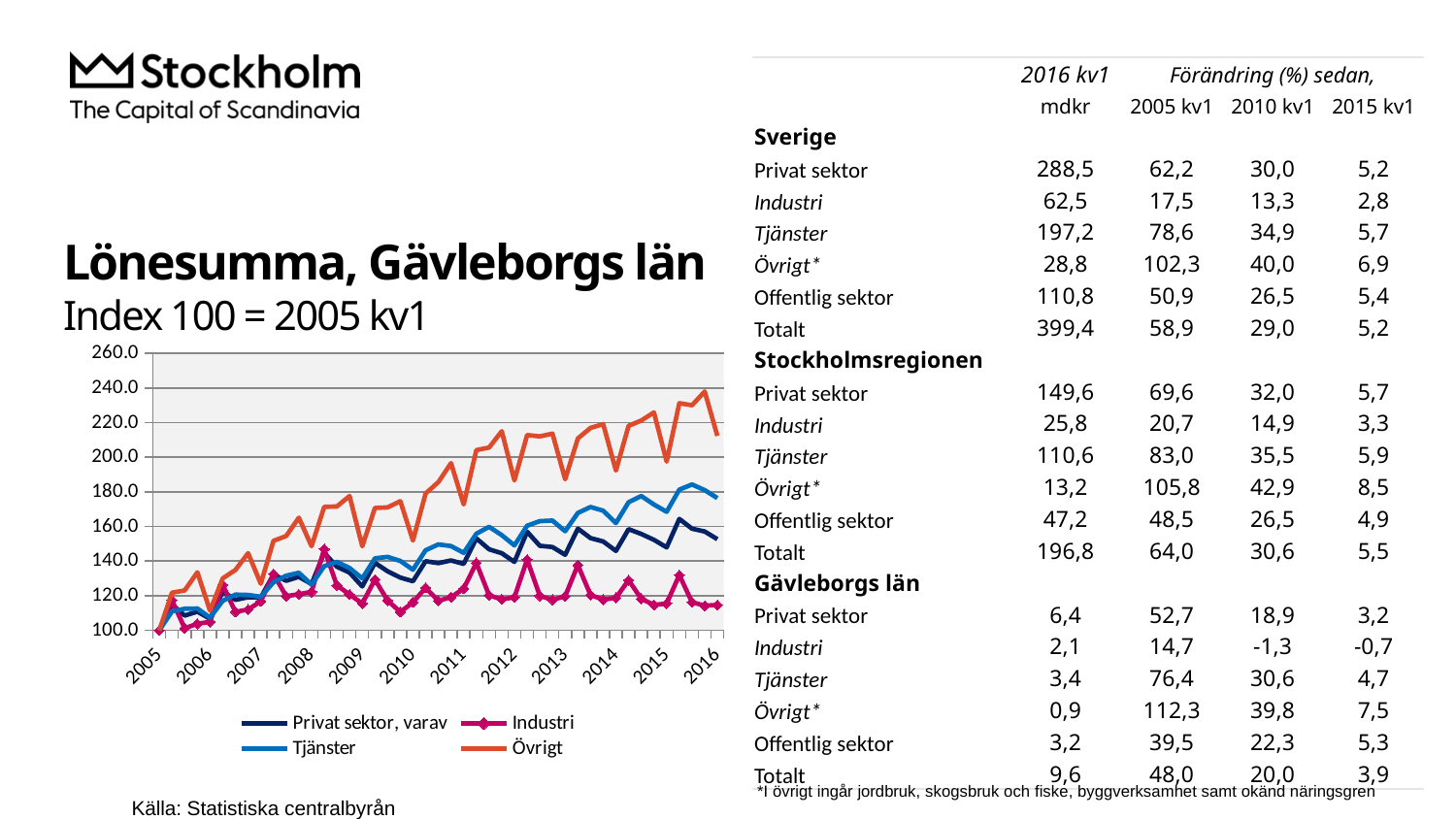
Which series are listed in the chart legend? Privat sektor, varav; Industri; Tjänster; Övrigt How many series does the chart legend list? 4 In 2016, which is higher: Tjänster or Privat sektor, varav? Tjänster Which series has the lowest value at the end of the period (2016)? Industri Is the value for Tjänster in 2015 greater or less than 160? greater What is the title of the chart? Lönesumma, Gävleborgs län How many years are labelled on the x axis of the chart? 12 Which series has the highest value at the end of the period (2016)? Övrigt Is the value for Övrigt in 2016 greater or less than 200? greater Is the value for Industri in 2016 greater or less than 140? less What kind of chart is shown on the slide? line chart Does the Övrigt series generally rise or fall from 2005 to 2016? rise